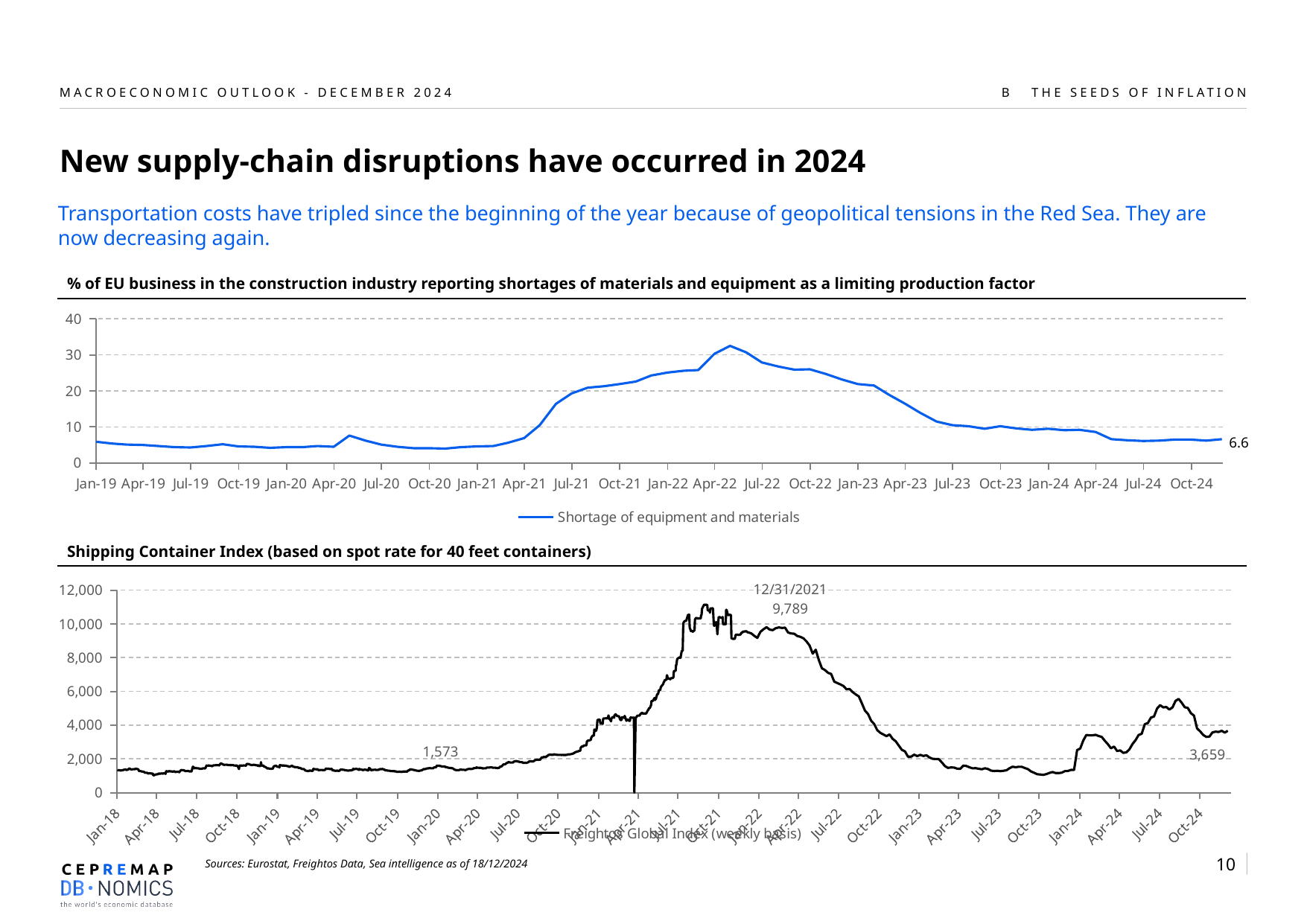
In the bottom chart, 'Shipping Container Index', what is the difference between the value labelled at 12/31/2021 and the latest labelled value? 6,130 In the bottom chart, 'Shipping Container Index', what value is labelled at 12/31/2021? 9,789 How many series does the legend of the top chart on shortages of materials and equipment list? 1 What kind of chart is the top chart, '% of EU business in the construction industry reporting shortages of materials and equipment as a limiting production factor'? Line chart In the bottom chart, 'Shipping Container Index', what is the value labelled at the end of the line (latest point)? 3,659 What is the legend entry of the top chart on shortages of materials and equipment? Shortage of equipment and materials In the bottom chart, 'Shipping Container Index', is the value at Jan-23 greater or less than 4,000? less In the top chart on shortages of materials and equipment, what is the value printed at the end of the line (latest point)? 6.6 In the bottom chart, 'Shipping Container Index', which is larger: the value labelled 1,573 or the latest labelled value 3,659? 3,659 In the top chart on shortages of materials and equipment, is the value at Jan-19 greater or less than 10? less In the top chart on shortages of materials and equipment, is the value at Jan-22 greater or less than 20? greater In the top chart on shortages of materials and equipment, does the line rise or fall between Jul-22 and Jul-23? Fall